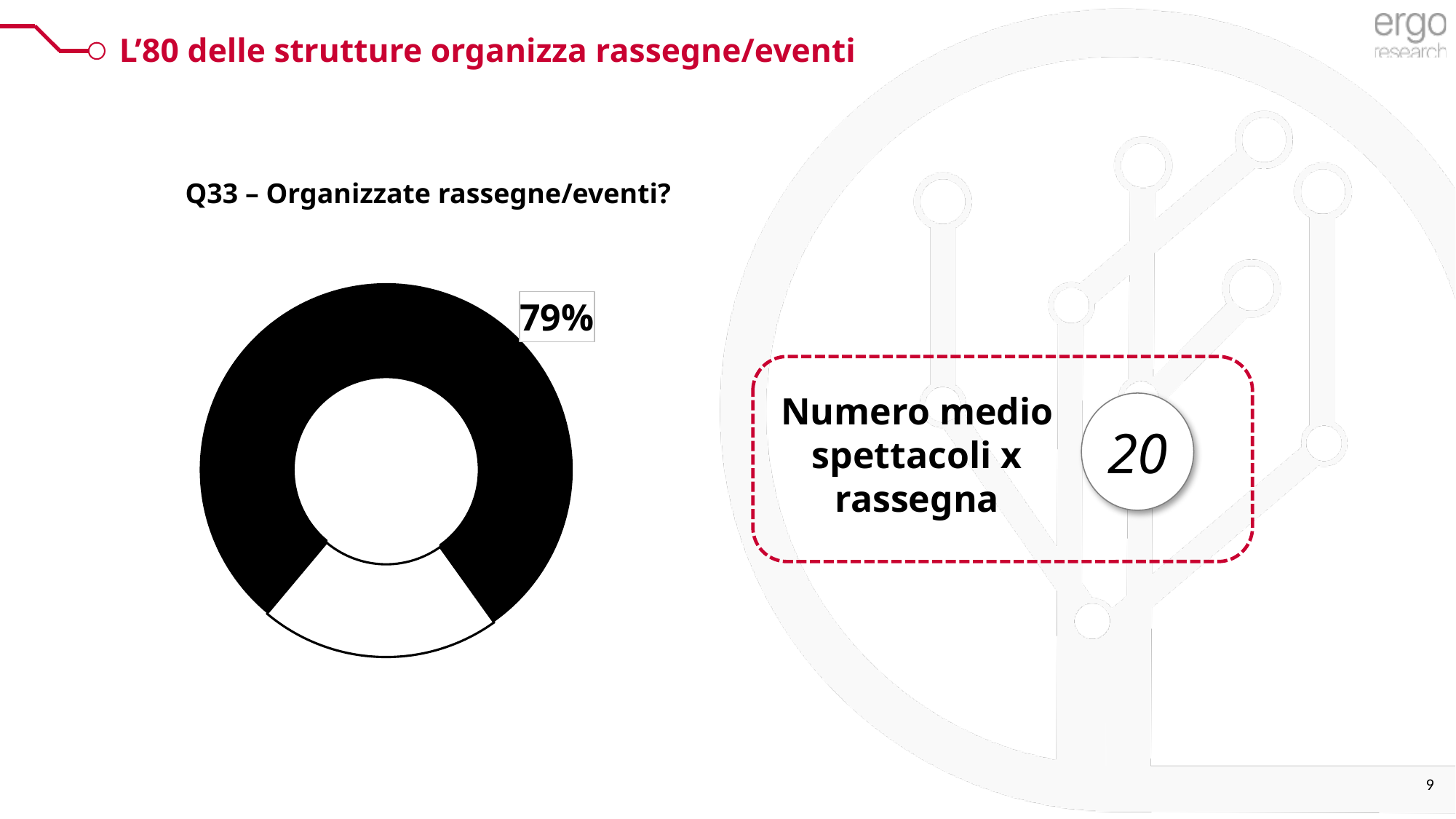
Which slice of the doughnut chart is larger, the black one or the white one? The black one What percentage is printed as the data label on the doughnut chart? 79% What share of the doughnut chart does the black slice represent? 79% Is the labelled slice of the doughnut chart greater or less than 50%? greater How many slices does the doughnut chart have? 2 What colour is the slice labelled 79% in the doughnut chart? Black What kind of chart is shown under "Q33 – Organizzate rassegne/eventi?"? Doughnut (pie) chart What is the title of the doughnut chart? Q33 – Organizzate rassegne/eventi?